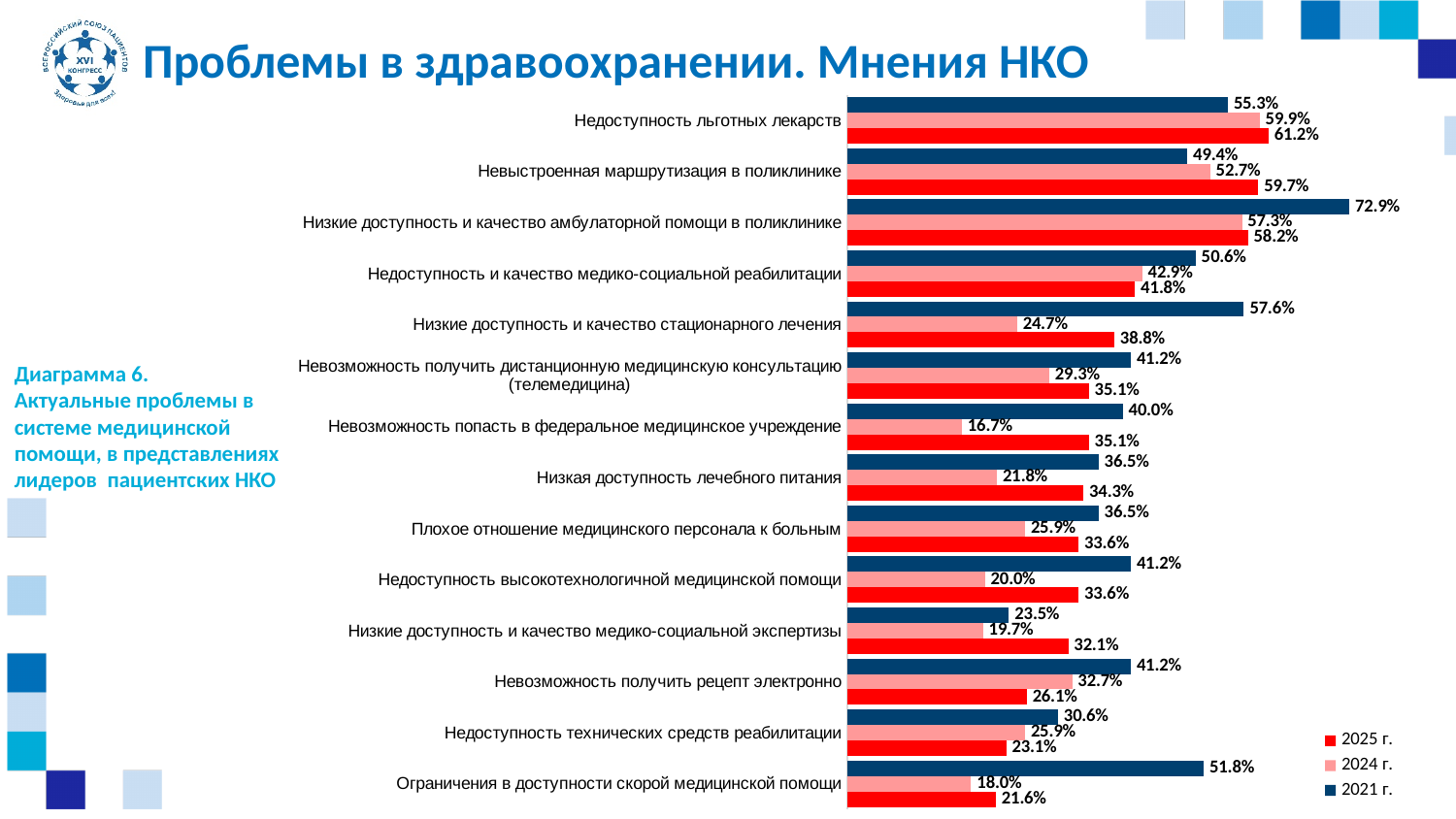
Which category has the highest 2025 г. value? Недоступность льготных лекарств What is the 2025 г. value for «Недоступность льготных лекарств»? 61.2% For «Низкие доступность и качество стационарного лечения», which is larger: the 2024 г. value or the 2025 г. value? 2025 г. How many categories are shown on the chart? 14 How many series does the legend list? 3 Which category has the lowest 2025 г. value? Ограничения в доступности скорой медицинской помощи What is the 2024 г. value for «Невозможность попасть в федеральное медицинское учреждение»? 16.7% Which category has the highest 2021 г. value? Низкие доступность и качество амбулаторной помощи в поликлинике What type of chart is shown on the slide? Bar chart Which colour represents the 2021 г. series in the legend? Dark blue What is the 2021 г. value for «Низкие доступность и качество амбулаторной помощи в поликлинике»? 72.9% What is the difference between the 2021 г. and 2025 г. values for «Ограничения в доступности скорой медицинской помощи»? 30.2%